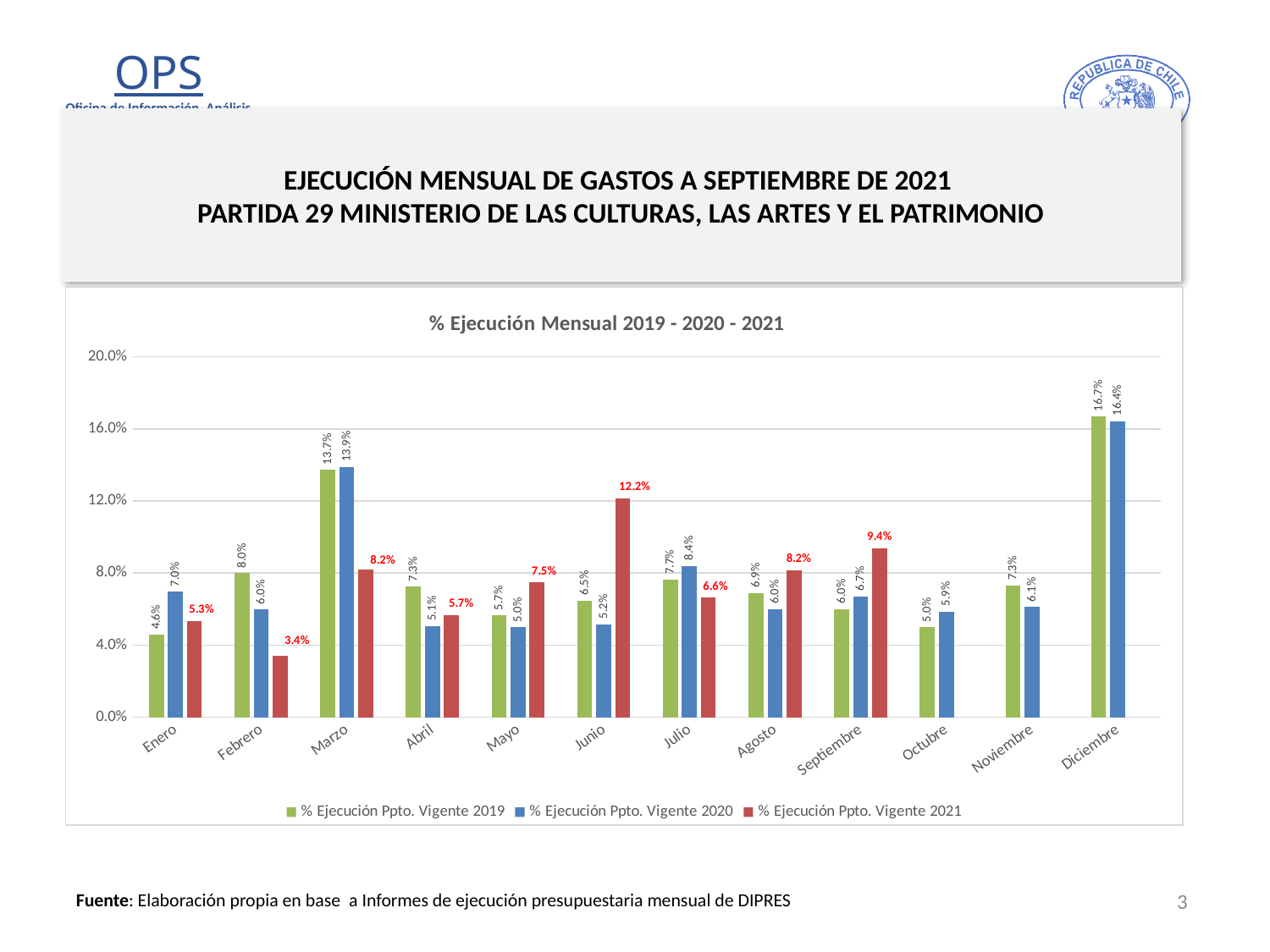
What is the value for % Ejecución Ppto. Vigente 2019 in Diciembre? 16.7% Which month has the lowest value for % Ejecución Ppto. Vigente 2019? Enero What is the value for % Ejecución Ppto. Vigente 2021 in Junio? 12.2% What is the value for % Ejecución Ppto. Vigente 2020 in Marzo? 13.9% What is the title of the chart? % Ejecución Mensual 2019 - 2020 - 2021 In Febrero, which is larger: the 2019 value or the 2021 value? 2019 What kind of chart is shown? Bar chart What is the difference between the 2021 and 2019 values in Septiembre? 3.4% How many series does the legend list? 3 How many months are shown on the x axis? 12 Which month has the highest value for % Ejecución Ppto. Vigente 2021? Junio Is the value for % Ejecución Ppto. Vigente 2020 in Diciembre greater or less than 16.0%? greater